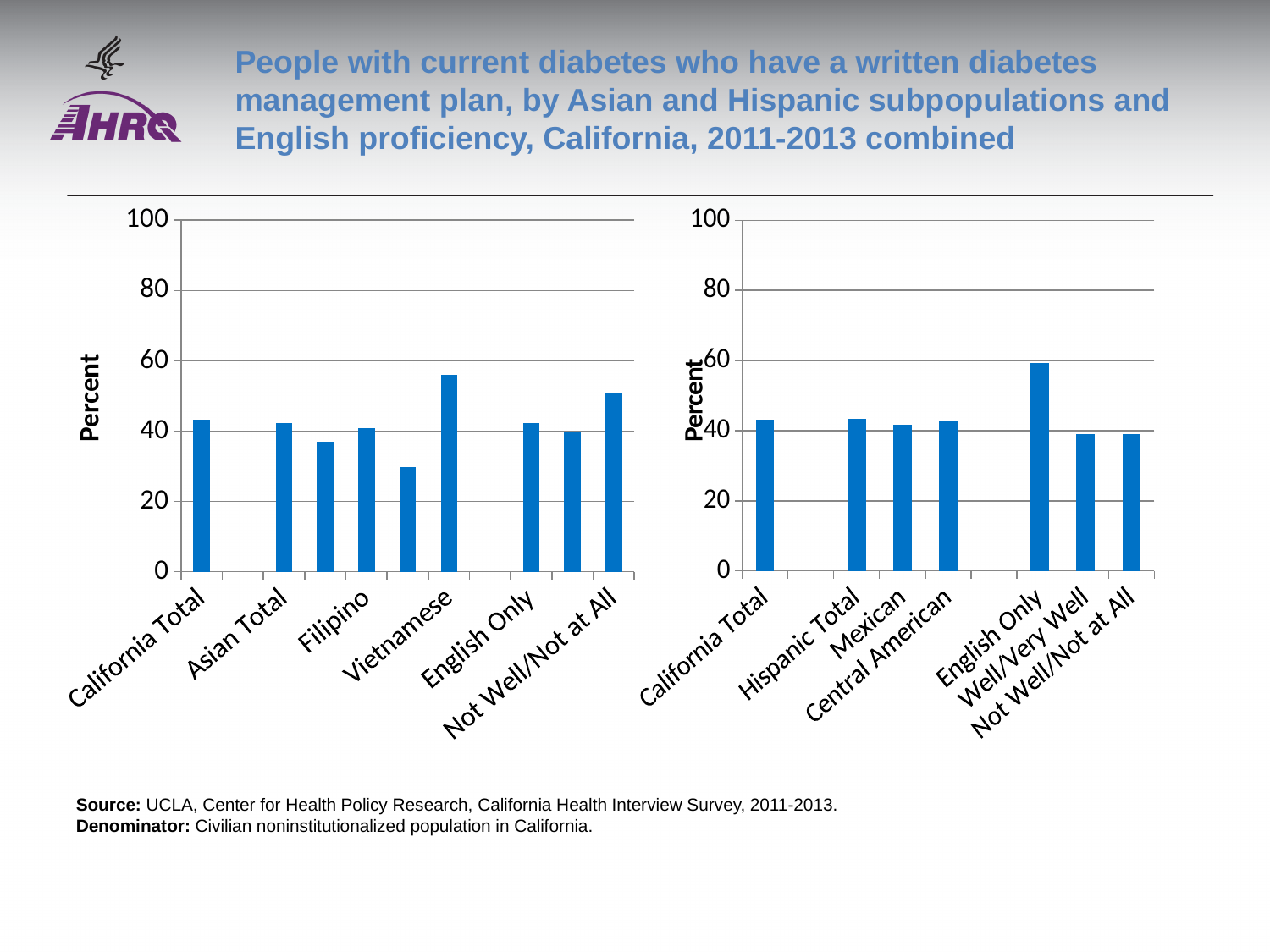
In the left chart (Asian subpopulations), which labeled category has the highest value? Vietnamese In the left chart, how many bars are plotted? 9 In the right chart, is the value for Well/Very Well greater or less than 40? less In the right chart, is the value for English Only greater or less than 40? greater In the left chart, is the value for Not Well/Not at All greater or less than 60? less What kind of chart is the left chart on the slide? bar chart In the right chart, which is larger, the value for English Only or the value for Not Well/Not at All? English Only In the right chart (Hispanic subpopulations), which category has the highest value? English Only What is the label on the vertical axis of the charts? Percent In the left chart, which is larger, the value for Vietnamese or the value for Filipino? Vietnamese In the right chart, how many bars are plotted? 7